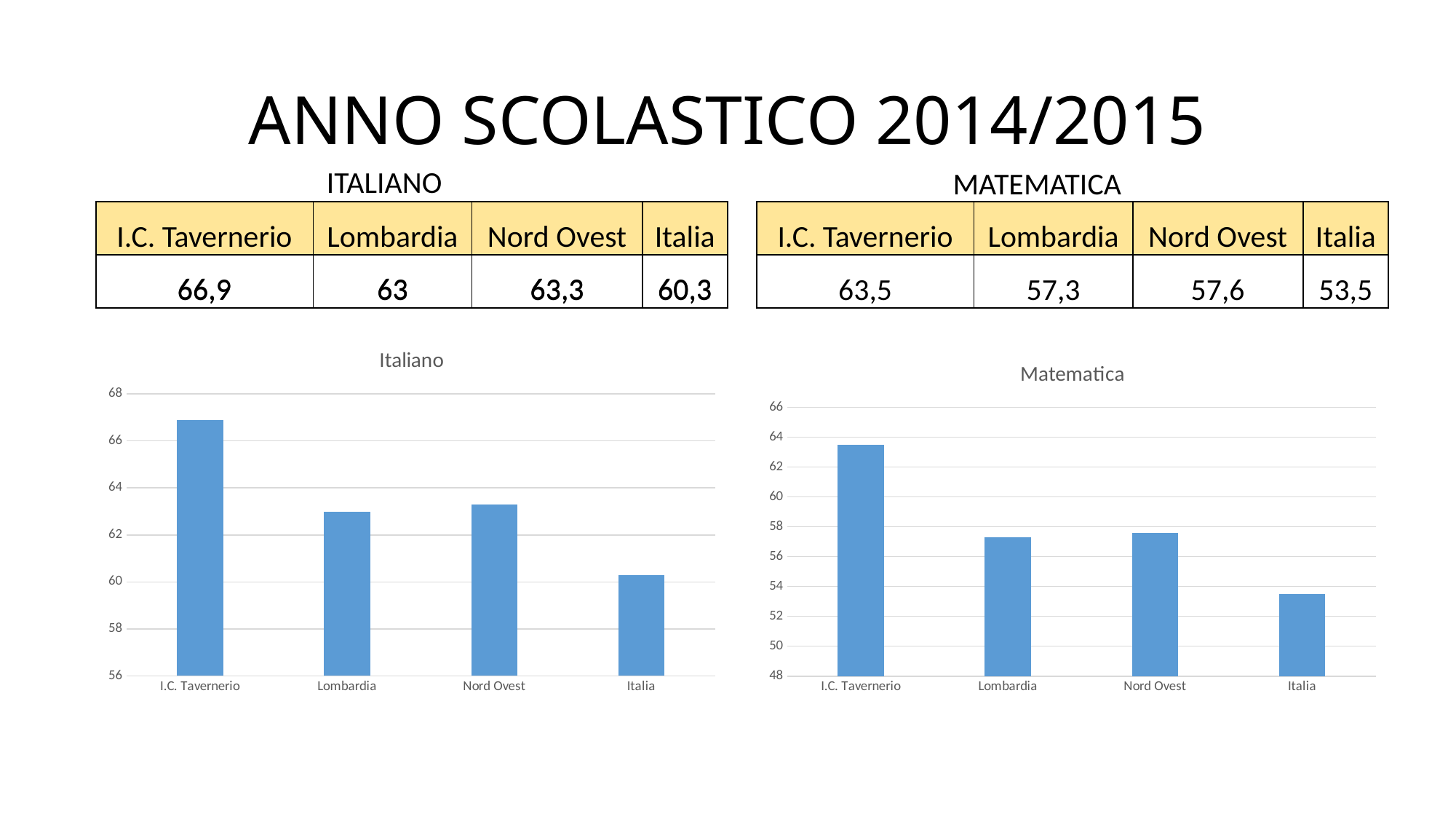
In the Matematica chart, is the value for Nord Ovest greater or less than 60? less In the Italiano chart, what is the value for I.C. Tavernerio? 66,9 In the Matematica chart, what is the difference between the values for I.C. Tavernerio and Lombardia? 6,2 In the Italiano chart, which category has the highest value? I.C. Tavernerio In the Italiano chart, which is larger, the value for Lombardia or the value for Italia? Lombardia What kind of chart is the Matematica chart? bar chart What is the title of the chart on the left side of the slide? Italiano How many categories are shown in the Italiano chart? 4 In the Matematica chart, what is the value for Lombardia? 57,3 In the Matematica chart, what is the value for Italia? 53,5 In the Matematica chart, which category has the lowest value? Italia In the Italiano chart, what is the difference between the values for I.C. Tavernerio and Italia? 6,6